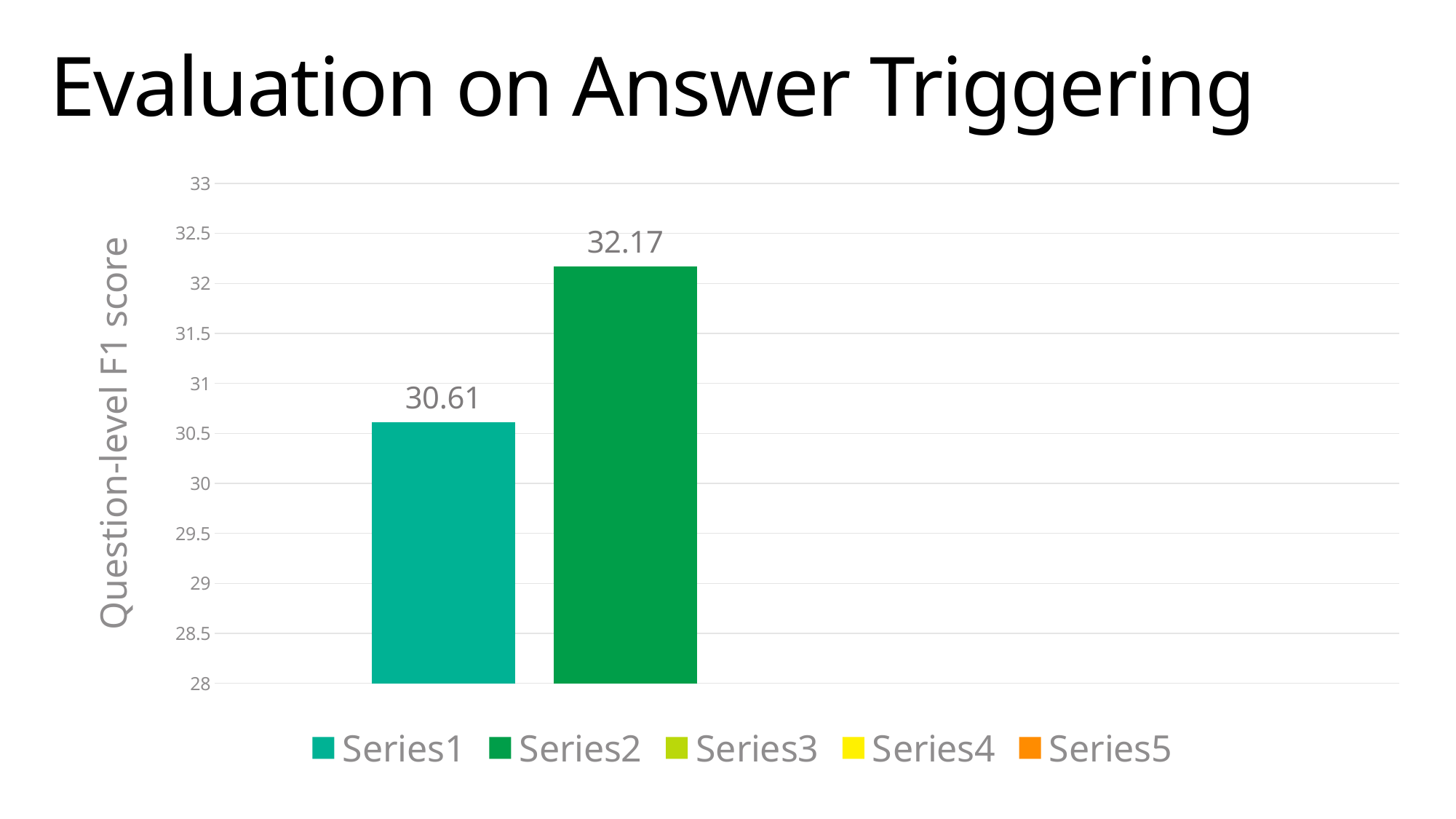
What is the difference between the values for Series2 and Series1? 1.56 What is the label of the vertical axis? Question-level F1 score Is the value for Series2 greater or less than 32? greater Which series has the lowest plotted value? Series1 What kind of chart is shown on the slide? bar chart What is the value for Series2? 32.17 Which is larger, the value for Series1 or the value for Series2? Series2 What is the value for Series1? 30.61 How many bars are plotted on the chart? 2 Is the value for Series1 greater or less than 31? less How many series does the legend list? 5 Which series has the highest plotted value? Series2